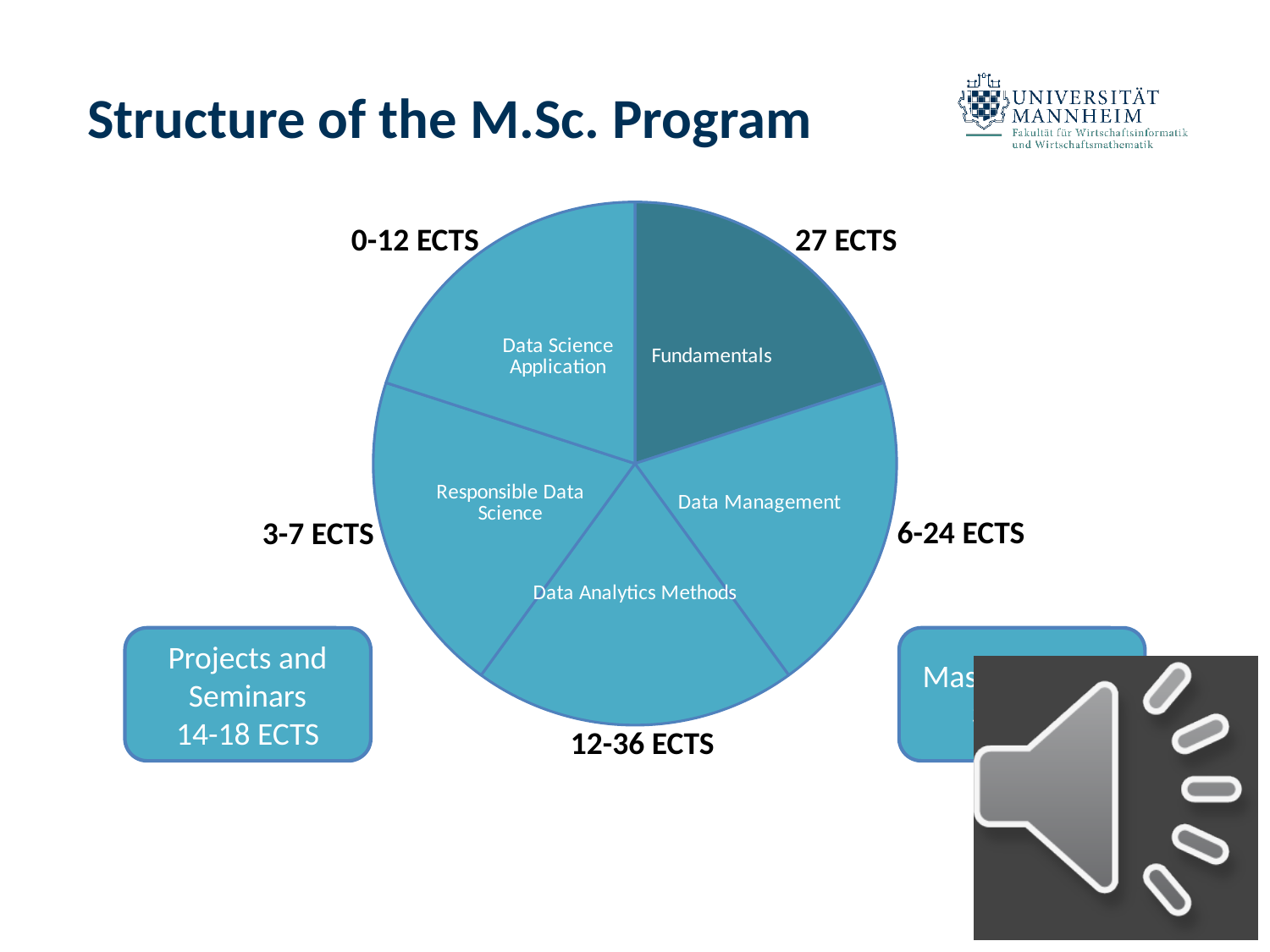
What ECTS value is printed next to the Fundamentals slice? 27 ECTS How many slices does the pie chart have? 5 What ECTS range is printed next to the Data Management slice? 6-24 ECTS What kind of chart is shown on the slide? pie chart What is the title of the slide containing the pie chart? Structure of the M.Sc. Program What ECTS range is printed next to the Data Analytics Methods slice? 12-36 ECTS What ECTS range is printed next to the Data Science Application slice? 0-12 ECTS Which slice of the pie chart is labelled with 12-36 ECTS? Data Analytics Methods Which slice of the pie chart is labelled with 27 ECTS? Fundamentals What ECTS range is printed next to the Responsible Data Science slice? 3-7 ECTS Which slice of the pie chart is shown in a darker colour than the others? Fundamentals